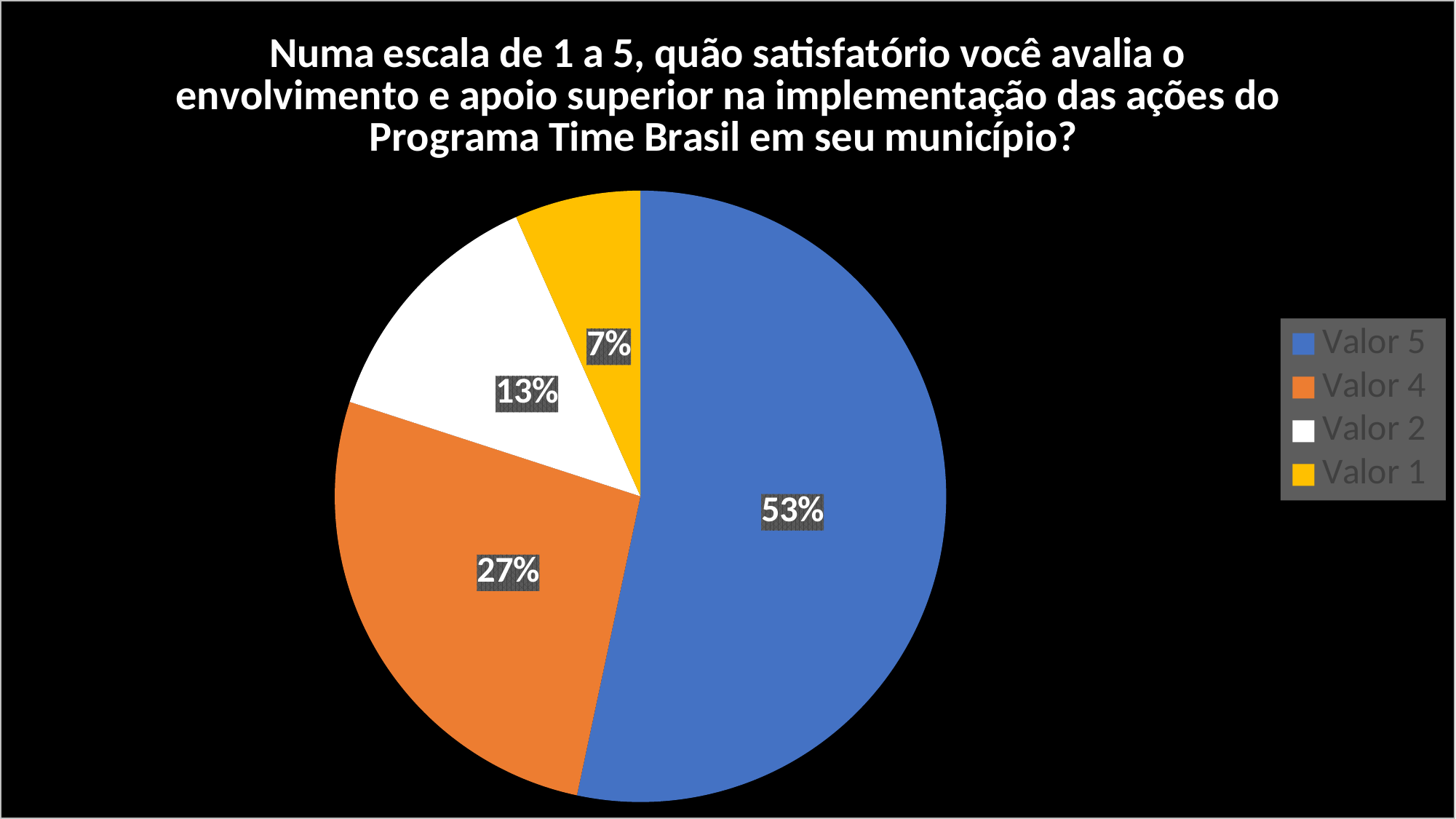
What share of the pie does Valor 4 represent? 27% Which is larger, the slice for Valor 4 or the slice for Valor 2? Valor 4 What is the difference in percentage points between Valor 2 and Valor 1? 6 How many slices does the pie chart have? 4 Which category has the largest slice of the pie? Valor 5 What colour is the slice for Valor 1? Yellow What share of the pie does Valor 1 represent? 7% Which category has the smallest slice of the pie? Valor 1 What share of the pie does Valor 2 represent? 13% What kind of chart is shown on the slide? Pie chart What is the difference in percentage points between Valor 5 and Valor 4? 26 What share of the pie does Valor 5 represent? 53%